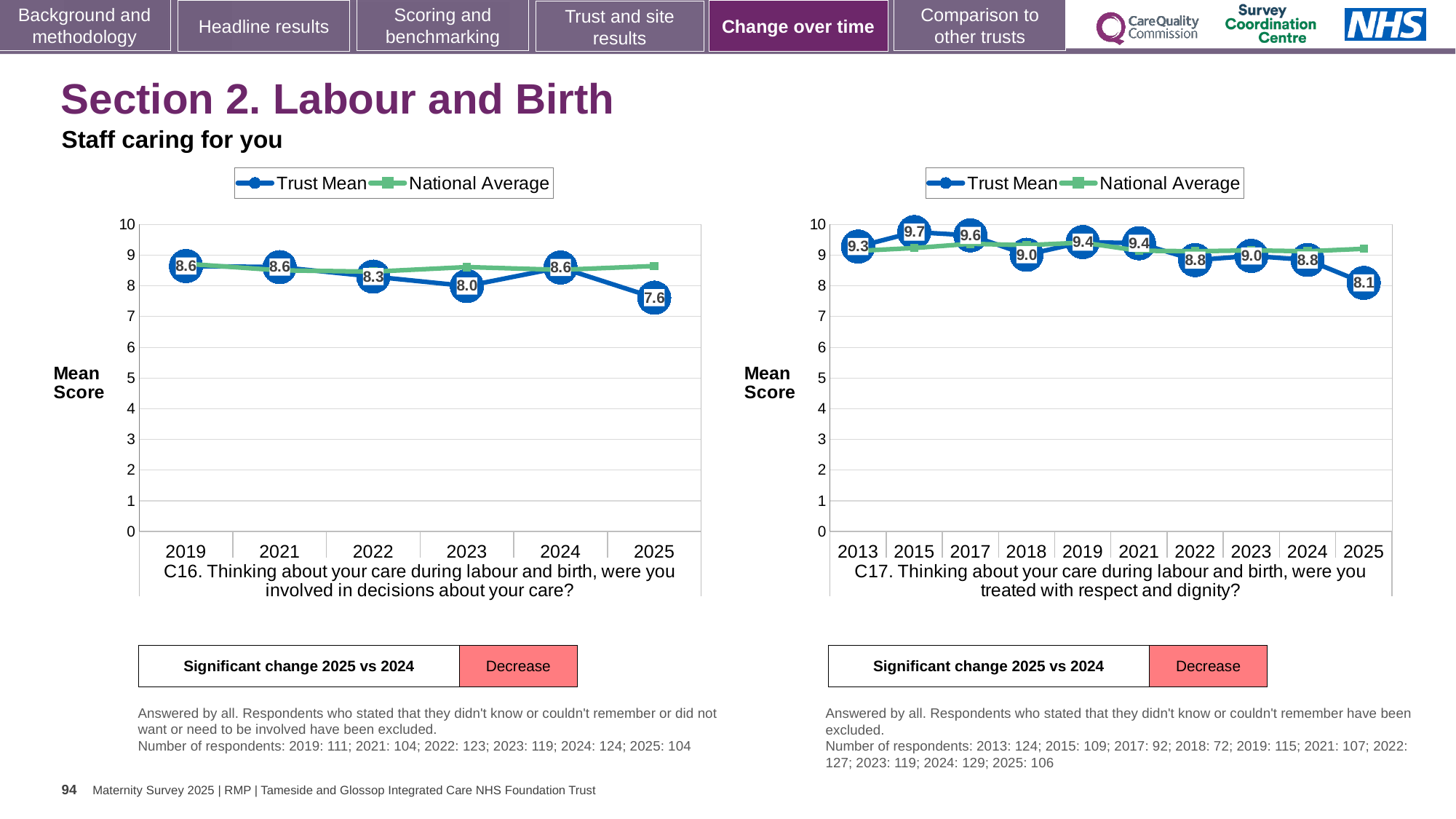
In the C17 chart (right), what is the Trust Mean for 2025? 8.1 In the C17 chart (right), is the Trust Mean for 2024 larger or smaller than the Trust Mean for 2023? smaller How many series does the legend of the C17 chart (right) list? 2 In the C16 chart (left), what is the Trust Mean for 2025? 7.6 In the C16 chart (left), how many years are plotted on the x axis? 6 In the C17 chart (right), which year has the highest Trust Mean? 2015 In the C16 chart (left), what is the Trust Mean for 2023? 8.0 In the C16 chart (left), which year has the lowest Trust Mean? 2025 In the C16 chart (left), what is the difference between the Trust Mean in 2024 and in 2025? 1.0 In the C17 chart (right), how many years are plotted on the x axis? 10 What type of chart is the C16 chart (left)? Line chart In the C17 chart (right), what is the Trust Mean for 2015? 9.7